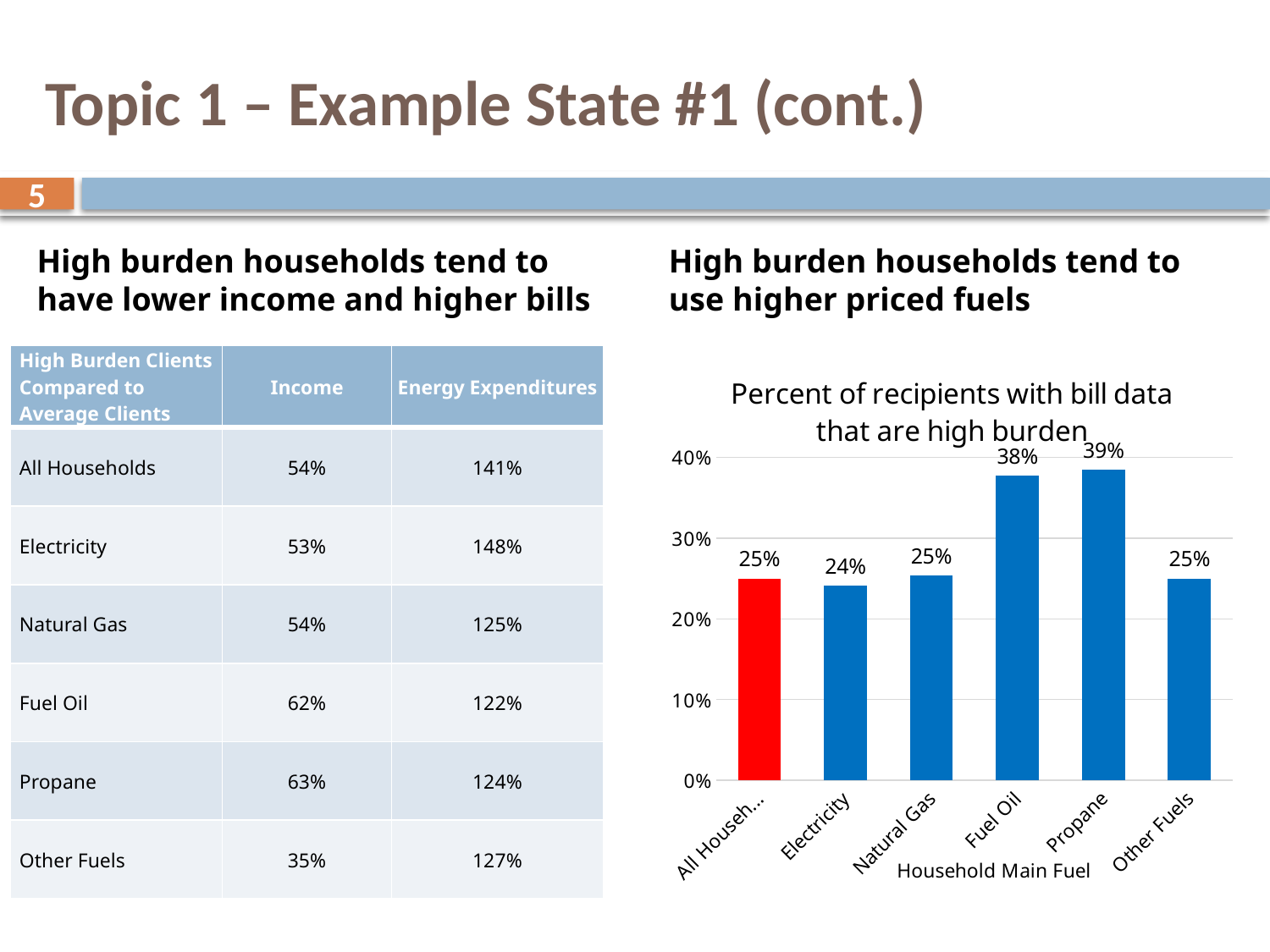
What is the difference between the values for Propane and Electricity? 15 percentage points Which is larger, the value for Fuel Oil or the value for Natural Gas? Fuel Oil What is the value for Fuel Oil in the chart? 38% What is the value for Electricity in the chart? 24% What is the value for Propane in the chart? 39% How many household main fuel categories are shown on the x axis of the chart? 6 What is the title of the chart? Percent of recipients with bill data that are high burden Which household main fuel has the highest percent of high burden recipients? Propane Which household main fuel has the lowest percent of high burden recipients? Electricity Is the value for Fuel Oil greater or less than 30%? greater What kind of chart is shown on the slide? Bar chart What is the value for Other Fuels in the chart? 25%